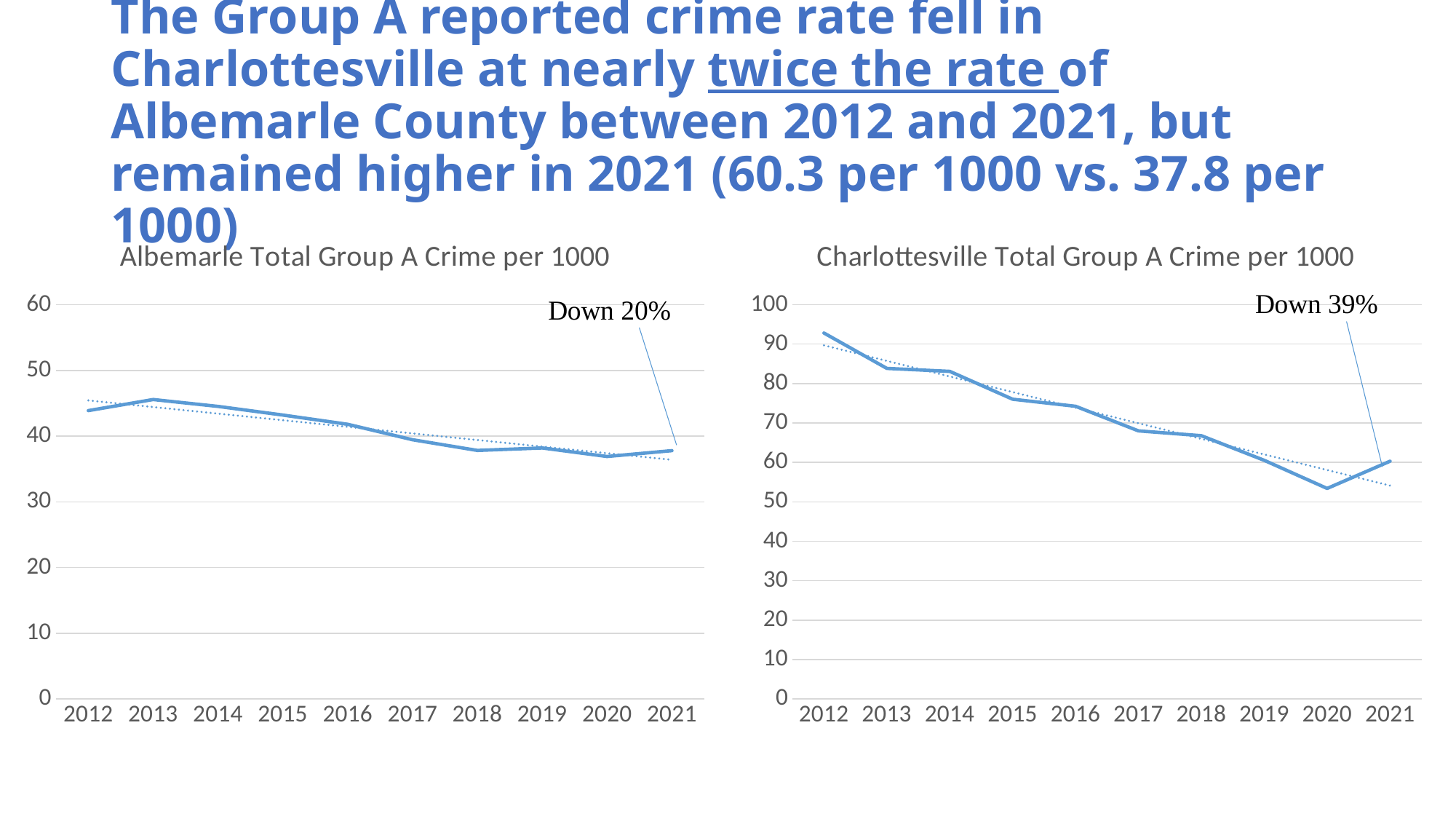
In the Charlottesville Total Group A Crime per 1000 chart, which year has the highest value? 2012 What percentage decline is annotated on the Charlottesville Total Group A Crime per 1000 chart? Down 39% In the Charlottesville Total Group A Crime per 1000 chart, do the values generally rise or fall from 2012 to 2021? fall According to the slide, what was the Charlottesville Group A crime rate per 1000 in 2021? 60.3 per 1000 In the Albemarle Total Group A Crime per 1000 chart, is the value for 2012 greater or less than 40? greater In the Charlottesville Total Group A Crime per 1000 chart, is the value for 2015 greater or less than 80? less In the Charlottesville Total Group A Crime per 1000 chart, which year has the lowest value? 2020 How many years are plotted on the x axis of the Charlottesville Total Group A Crime per 1000 chart? 10 In the Charlottesville Total Group A Crime per 1000 chart, is the value for 2012 greater or less than 90? greater In the Charlottesville Total Group A Crime per 1000 chart, is the value for 2012 larger or smaller than the value for 2021? larger What kind of chart is the Albemarle Total Group A Crime per 1000 chart? line chart